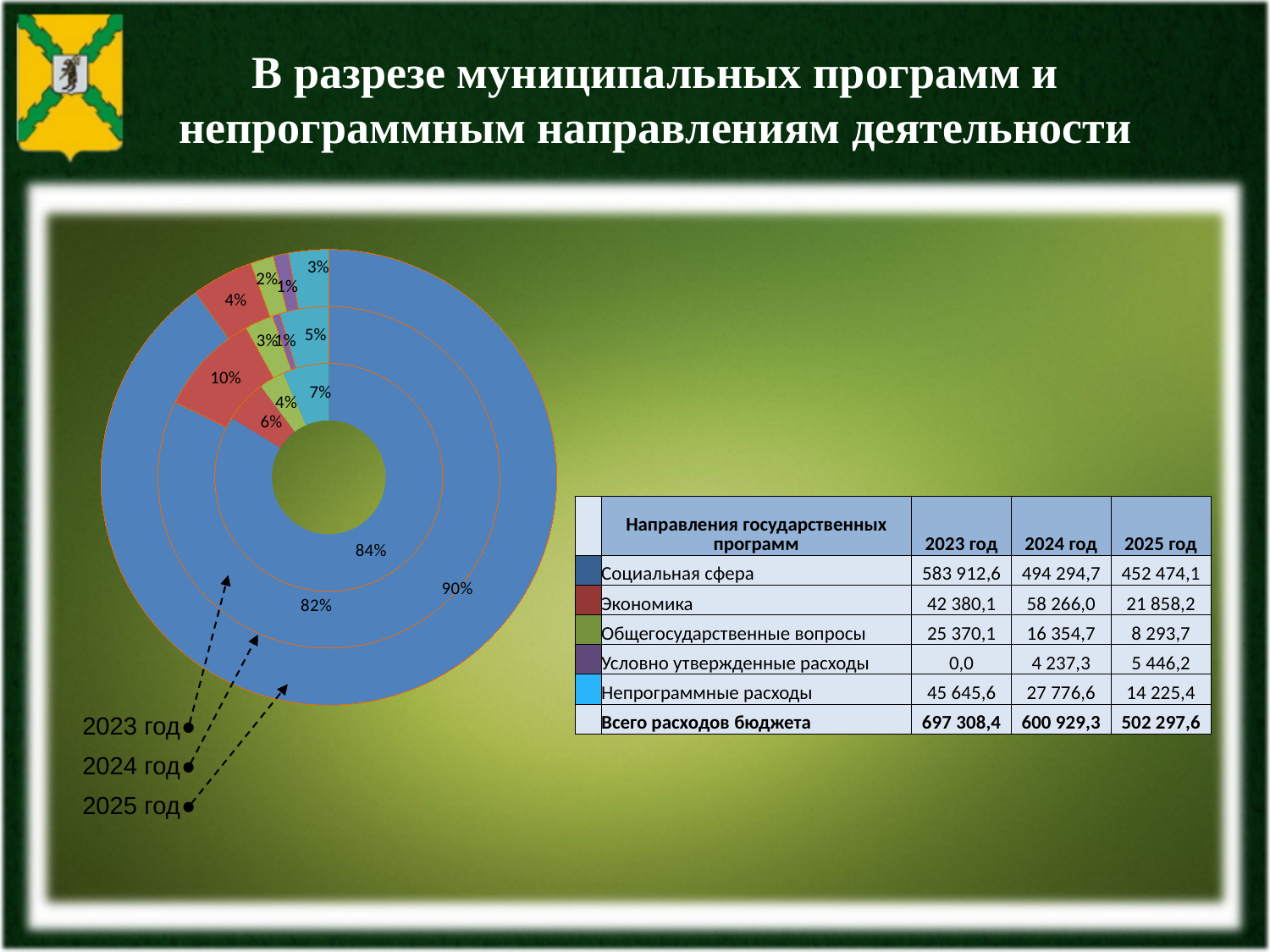
In the outer ring (2025 год), what share does the red slice (Экономика) have? 4% In the inner ring (2023 год), what share does the cyan slice (Непрограммные расходы) have? 7% Which ring shows the larger share for the red slice (Экономика): the middle ring (2024 год) or the outer ring (2025 год)? 2024 год (middle ring) How many rings (years) does the doughnut chart contain? 3 Which category has the largest share in every ring of the chart? Социальная сфера What share does the largest slice of the middle ring (2024 год) have? 82% Which year does the arrow pointing to the innermost ring of the chart label? 2023 год What is the difference between the blue slice's share in the outer ring (90%) and in the middle ring (82%)? 8% What kind of chart is shown on the slide? doughnut (pie) chart